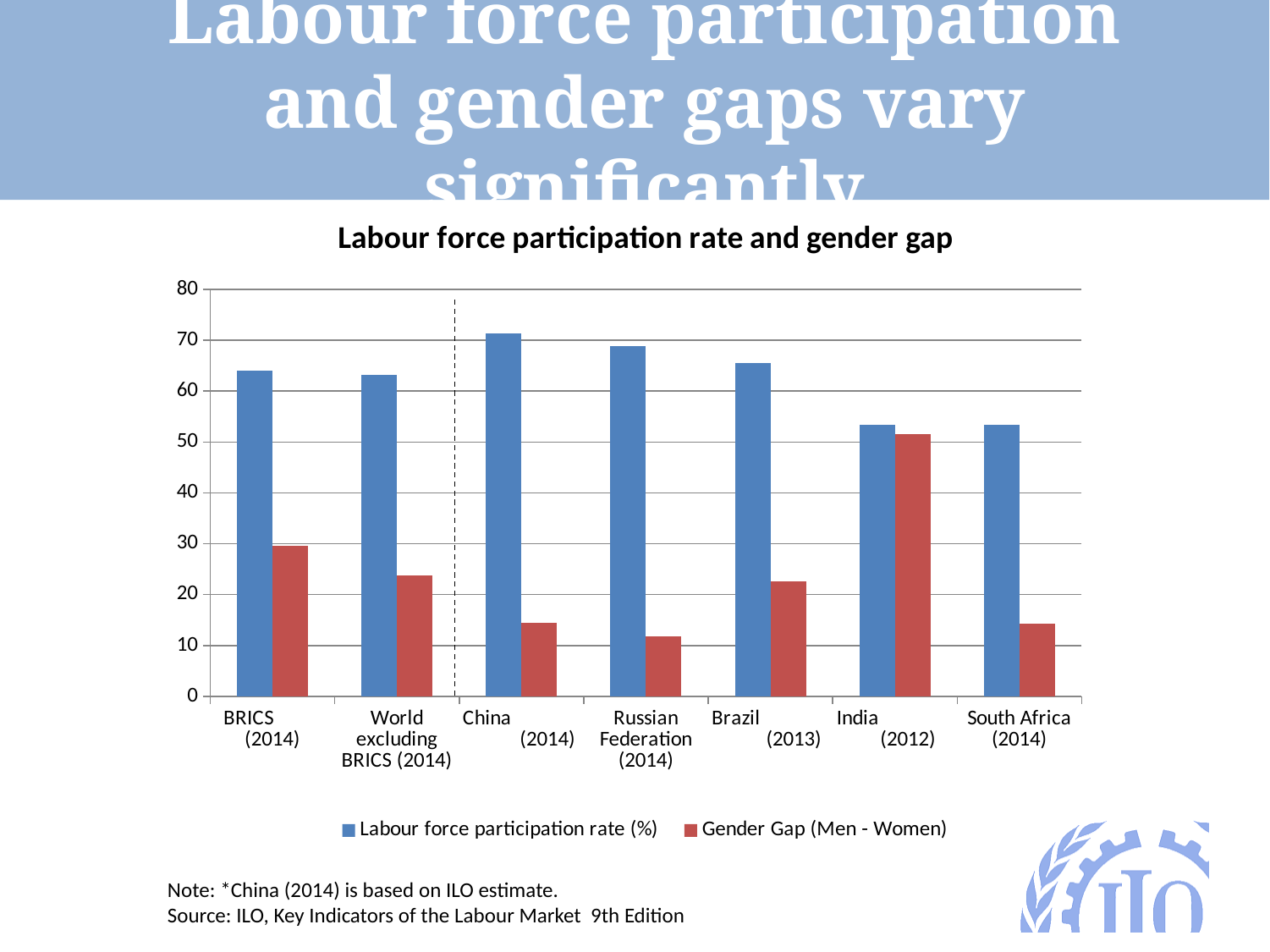
Is the Labour force participation rate (%) for South Africa (2014) greater or less than 60? less Which is larger: the Gender Gap (Men - Women) for BRICS (2014) or for China (2014)? BRICS (2014) Is the Labour force participation rate (%) for China (2014) greater or less than 60? greater Is the Gender Gap (Men - Women) for Russian Federation (2014) greater or less than 20? less What type of chart is shown on the slide? bar chart How many categories are shown on the x axis? 7 Which category has the smallest Gender Gap (Men - Women)? Russian Federation (2014) Which category has the highest Labour force participation rate (%)? China (2014) How many series does the legend list? 2 Which category has the largest Gender Gap (Men - Women)? India (2012) What is the title of the chart? Labour force participation rate and gender gap